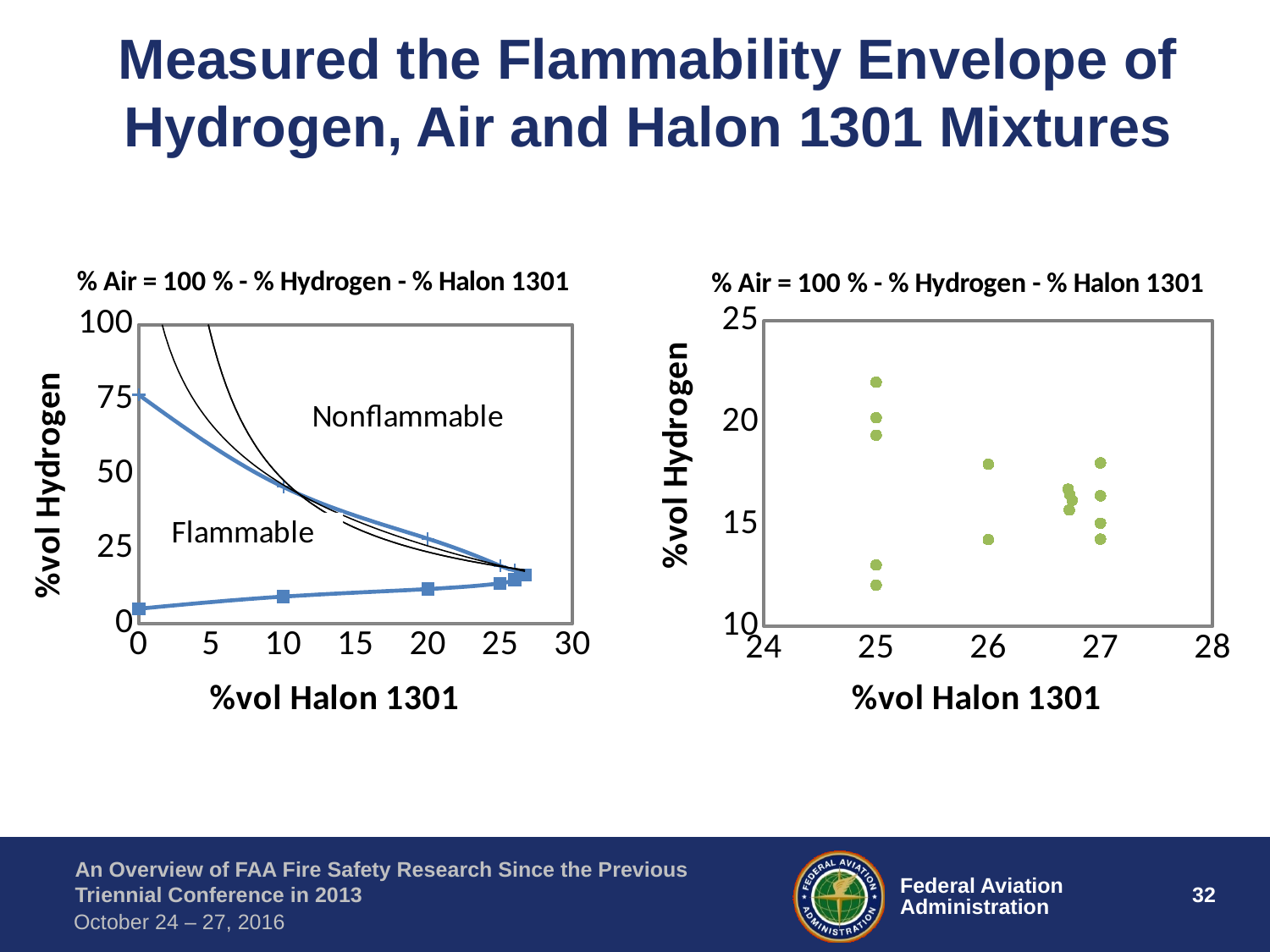
On the left chart, is the %vol Hydrogen of the lower curve at 0 %vol Halon 1301 greater or less than 25? less What kind of chart is the chart on the right of the slide? scatter chart On the left chart, is the %vol Hydrogen of the upper curve at 20 %vol Halon 1301 greater or less than 50? less On the left chart, what is the title of the x axis? %vol Halon 1301 On the left chart, does the lower boundary curve rise or fall as %vol Halon 1301 increases? rise On the right chart, what is the title of the y axis? %vol Hydrogen On the right chart, is the lowest point at 25 %vol Halon 1301 greater or less than 15 %vol Hydrogen? less On the left chart, does the upper boundary curve rise or fall as %vol Halon 1301 increases? fall On the right chart, how many points are plotted at 26 %vol Halon 1301? 2 On the right chart, what is the highest value shown on the x axis? 28